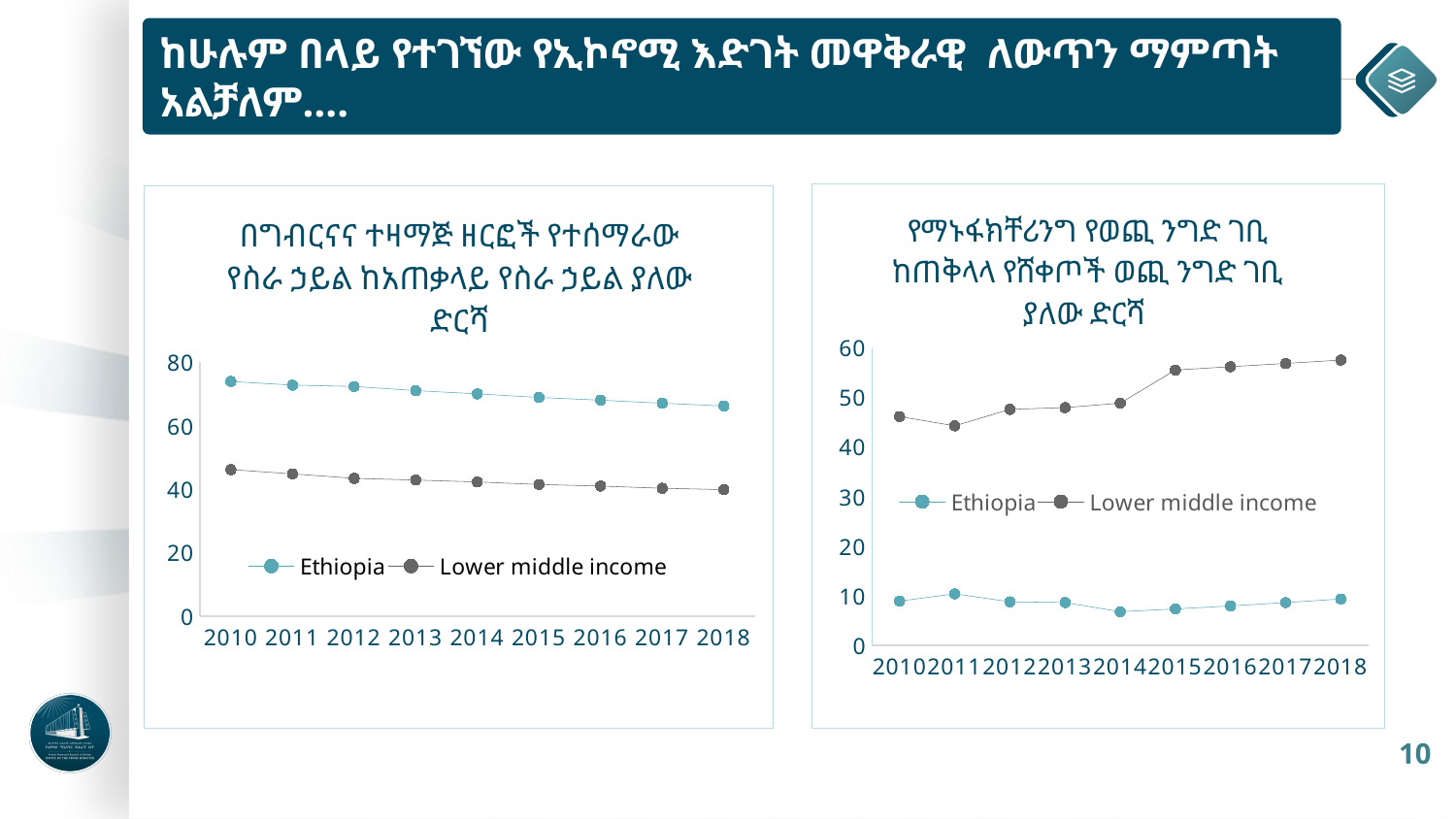
In the left chart, does the Ethiopia line rise or fall from 2010 to 2018? fall In the right chart, is the value for Lower middle income in 2018 greater or less than 50? greater In the left chart, is the value for Ethiopia in 2010 greater or less than 60? greater How many series does the legend of the left chart list? 2 What kind of chart is the left chart on the slide? line chart What kind of chart is the right chart on the slide? line chart How many years are shown on the x axis of the right chart? 9 In the left chart, which series is higher in 2014, Ethiopia or Lower middle income? Ethiopia In the right chart, does the Lower middle income line rise or fall overall from 2010 to 2018? rise In the right chart, which series is higher in 2018, Ethiopia or Lower middle income? Lower middle income In the left chart, is the value for Lower middle income in 2018 greater or less than 60? less